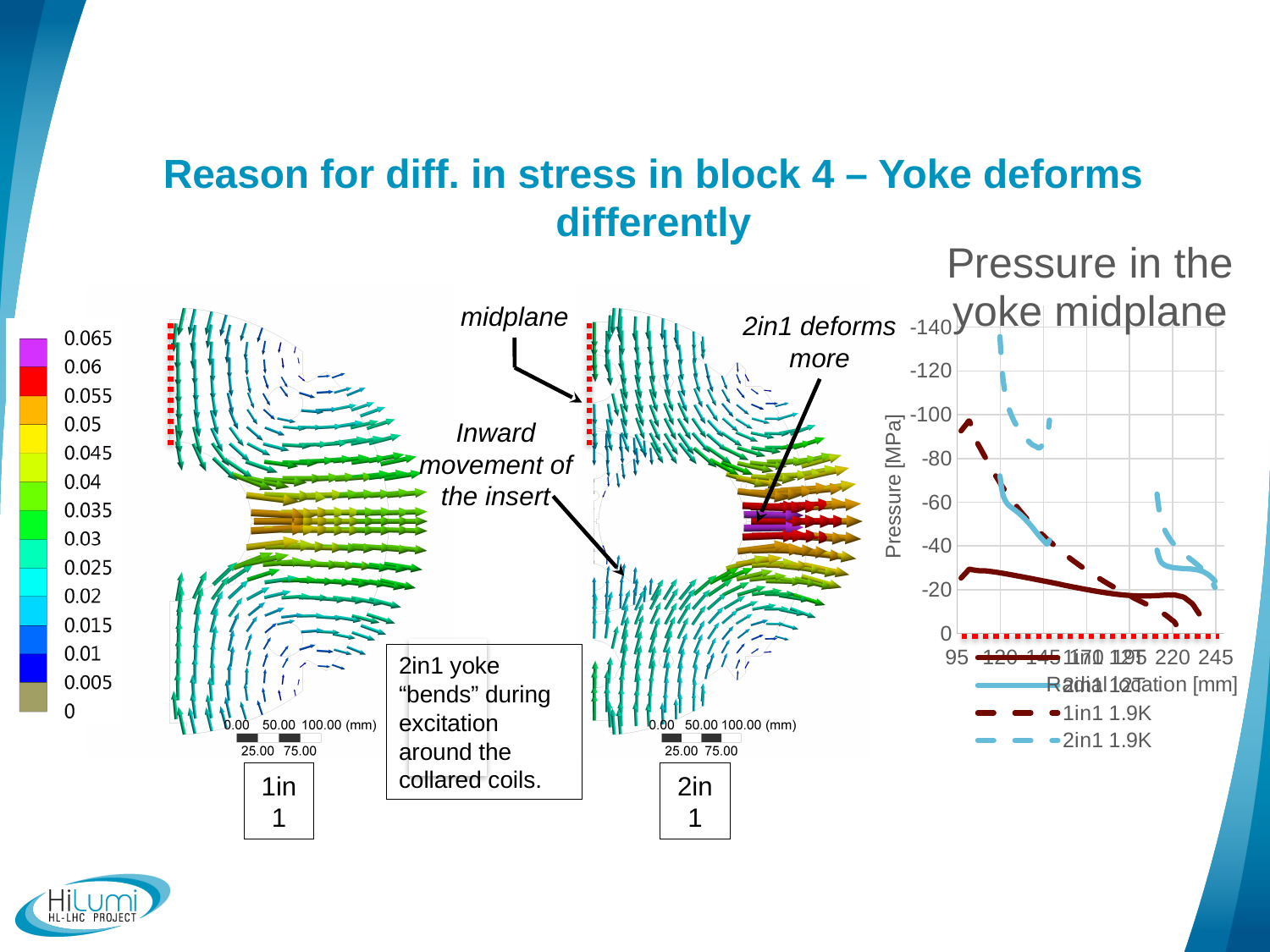
In the 'Pressure in the yoke midplane' chart, near 120 mm, which series shows the more negative pressure, 1in1 1.9K or 2in1 1.9K? 2in1 1.9K In the 'Pressure in the yoke midplane' chart, does the 1in1 1.9K line move toward 0 or away from 0 as radial location increases? toward 0 In the 'Pressure in the yoke midplane' chart, what is the last tick value on the x axis? 245 In the 'Pressure in the yoke midplane' chart, is the value for 1in1 1.9K at 95 mm greater or less than -80? less In the 'Pressure in the yoke midplane' chart, what is the topmost tick value on the y axis? -140 In the 'Pressure in the yoke midplane' chart, what is the first tick value on the x axis? 95 What is the title of the chart on the right of the slide? Pressure in the yoke midplane What kind of chart is 'Pressure in the yoke midplane'? line chart In the 'Pressure in the yoke midplane' chart, what is the label of the y axis? Pressure [MPa]